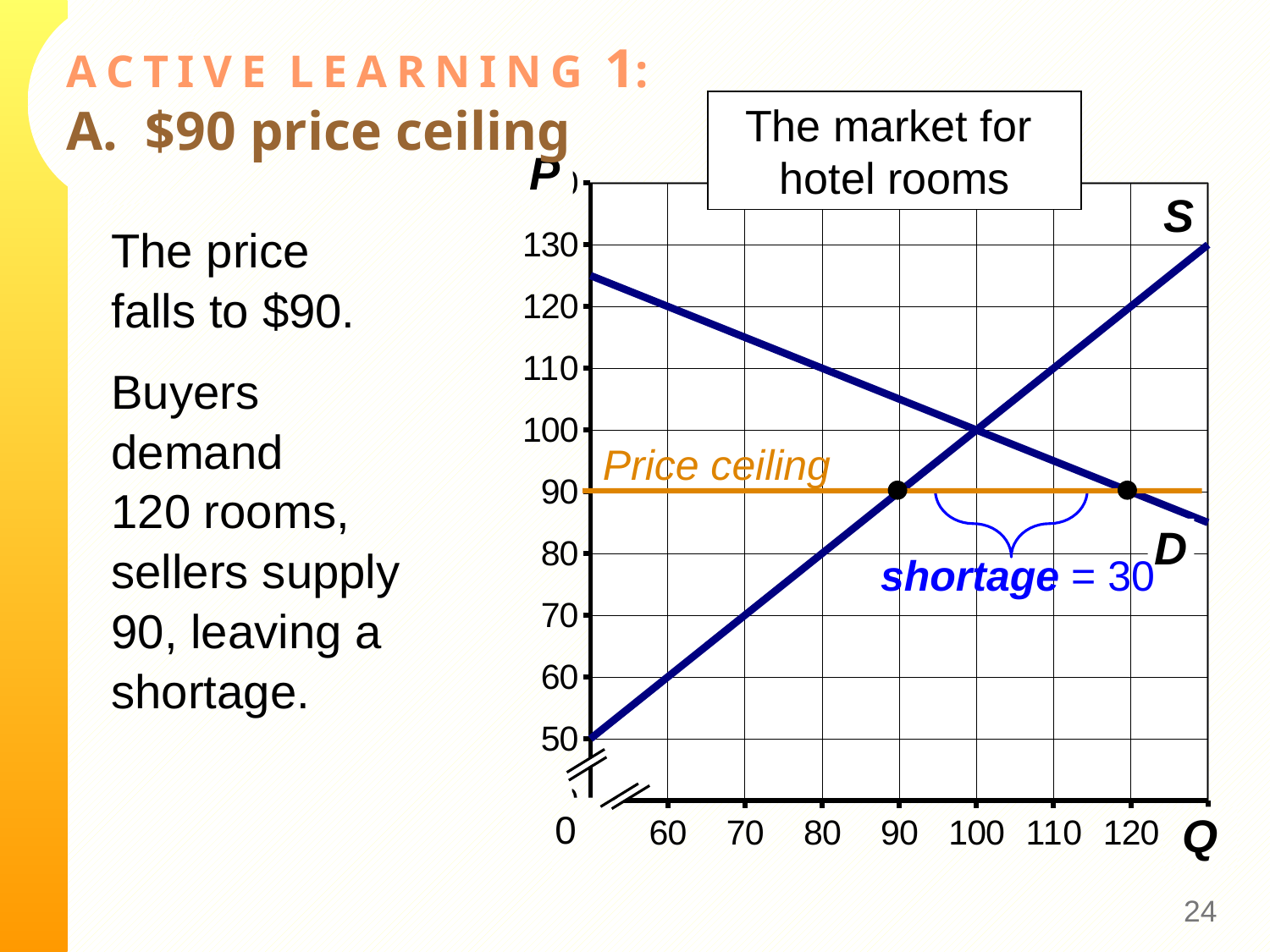
At what price is the price ceiling set in the chart? 90 What is the title of the chart? The market for hotel rooms At what quantity do the supply and demand curves intersect? 100 At what price do the supply and demand curves intersect? 100 Does the demand curve D rise or fall as quantity increases along the x axis? fall At a quantity of 120, which curve is at a higher price, S or D? S At the price ceiling of 90, what quantity do sellers supply according to the chart? 90 What kind of chart is shown on the slide? line chart Is the price on the demand curve at a quantity of 70 greater or less than 110? greater At the price ceiling of 90, what quantity do buyers demand according to the chart? 120 What is the size of the shortage labeled on the chart? 30 What is the difference between the quantity demanded and the quantity supplied at the price ceiling of 90? 30